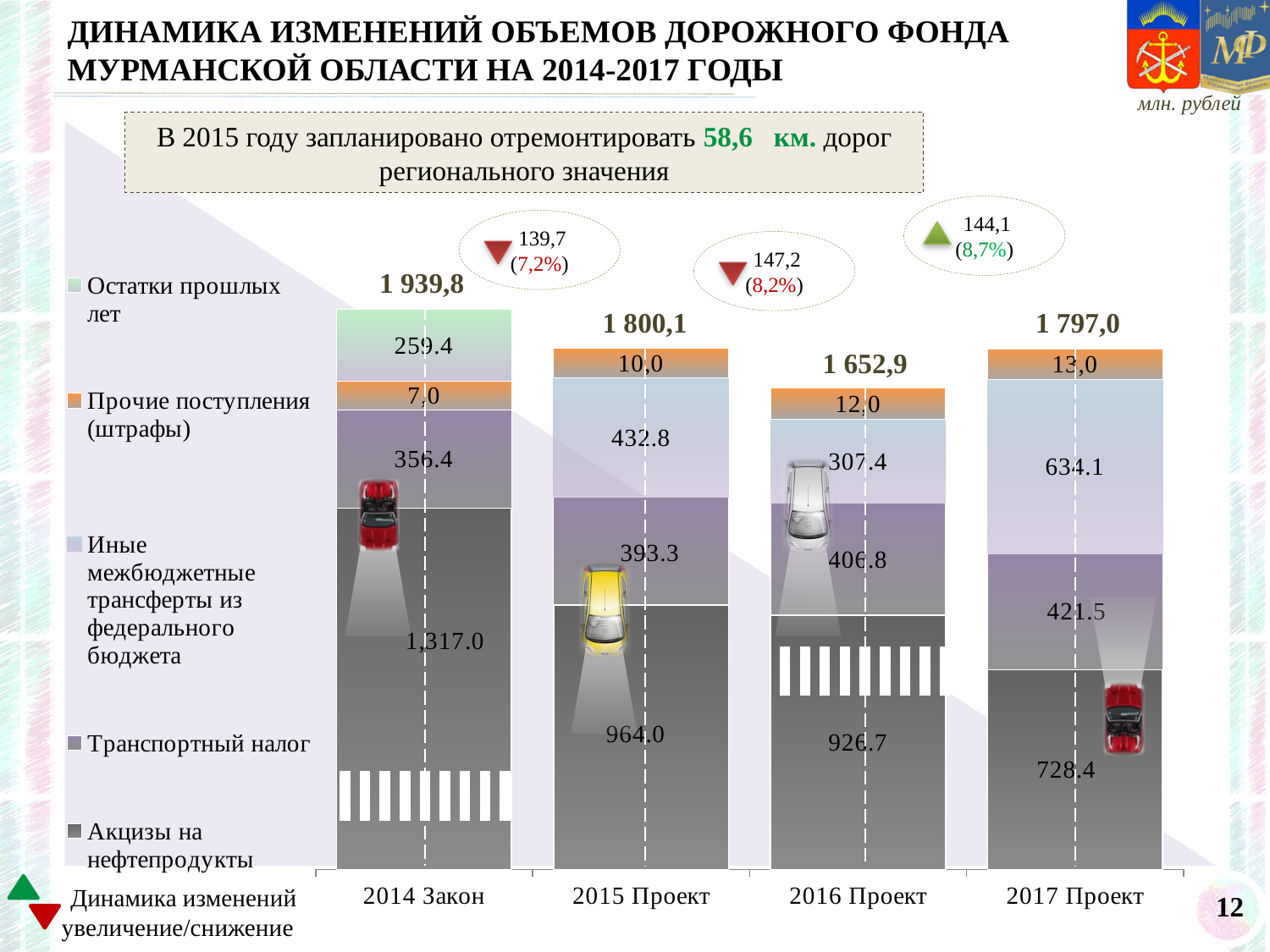
What type of chart is shown on the slide? stacked bar chart How many categories (years) are shown on the x axis of the chart? 4 What is the total value of the bar for 2016 Проект? 1 652,9 What is the total value of the bar for 2014 Закон? 1 939,8 Which year has the lowest total value of the road fund? 2016 Проект What is the value of Транспортный налог for 2017 Проект? 421.5 What is the value of Акцизы на нефтепродукты for 2015 Проект? 964.0 Which year has the highest total value of the road fund? 2014 Закон What is the value of Иные межбюджетные трансферты из федерального бюджета for 2016 Проект? 307.4 What is the value of Прочие поступления (штрафы) for 2014 Закон? 7,0 Which is larger: Акцизы на нефтепродукты for 2016 Проект or for 2017 Проект? 2016 Проект How many series does the legend of the chart list? 5